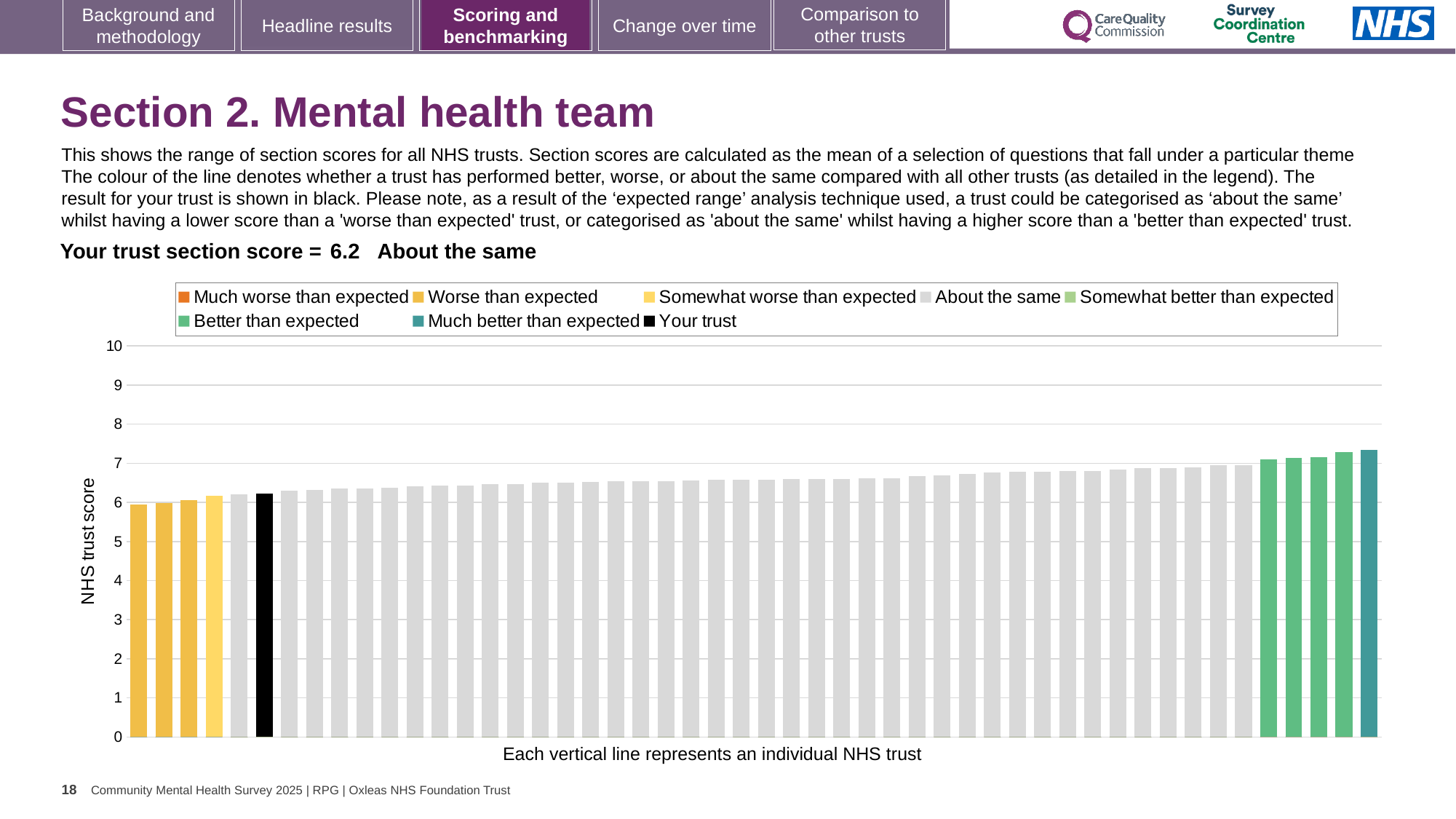
How many bars are coloured as 'Worse than expected' (dark yellow)? 3 What is the label on the vertical axis of the chart? NHS trust score Which legend category does the tallest bar belong to? Much better than expected Do the bar values rise or fall from left to right along the x axis? rise What is the section score for your trust shown on the slide? 6.2 Is the value of the tallest bar (the rightmost bar) greater or less than 7? greater Is the value of the shortest bar (the leftmost bar) greater or less than 7? less Is the value for your trust (the black bar) greater or less than 5? greater How many bars are coloured as 'Better than expected' (green)? 4 How many entries does the chart legend list? 8 How many bars are coloured as 'Much better than expected' (teal)? 1 What kind of chart is shown on the slide? bar chart